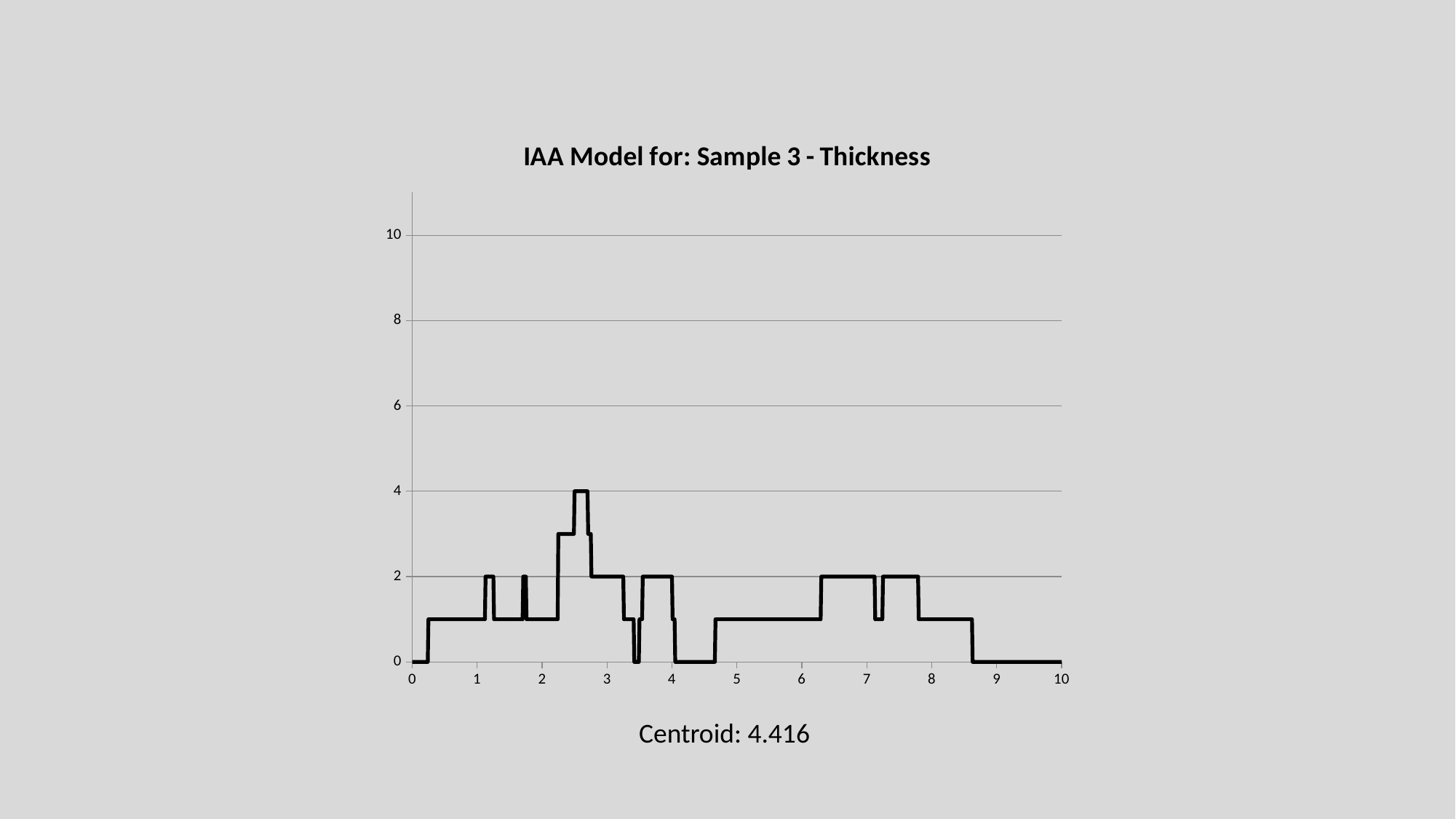
Is the value of the line at x = 8 greater or less than 2? less What is the value of the line at x = 6.5? 2 What is the highest value the line reaches? 4 What is the title of the chart? IAA Model for: Sample 3 - Thickness What centroid value is printed below the chart? 4.416 What is the difference between the value of the line at x = 3 and at x = 9? 2 What is the value of the line at x = 4.5? 0 What is the value of the line at x = 3? 2 What kind of chart is shown on the slide? line chart Is the value of the line at x = 5 greater or less than 2? less What is the value of the line at x = 9? 0 Which is larger, the value of the line at x = 3 or at x = 9? x = 3